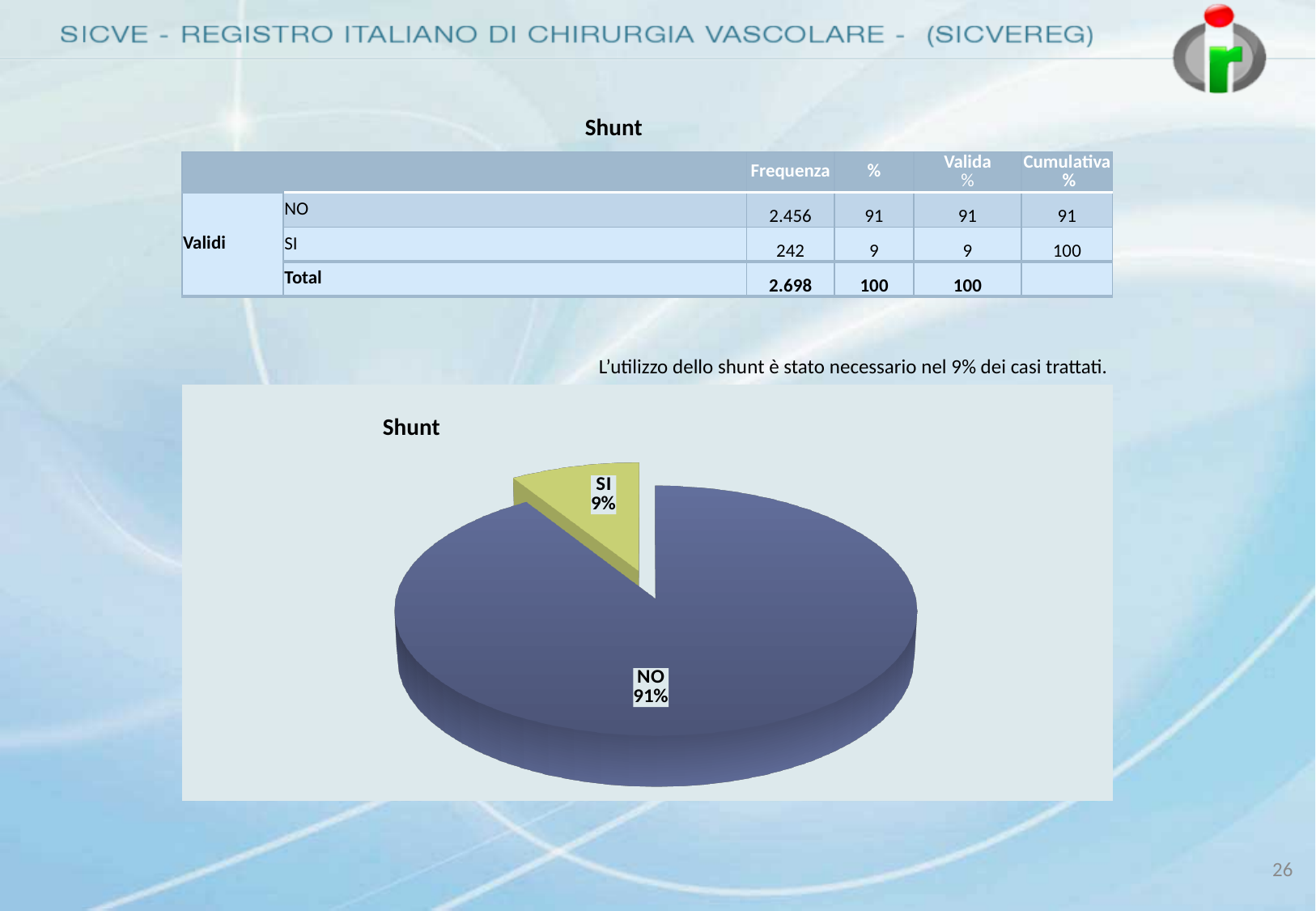
Which slice of the pie is the smallest? SI What colour is the SI slice of the pie? yellow-green What kind of chart is shown on the slide? pie chart What share of the pie does the SI slice represent? 9% What is the title of the chart? Shunt What is the difference in percentage points between the NO slice and the SI slice? 82 How many slices does the pie chart have? 2 What share of the pie does the NO slice represent? 91% Which slice of the pie is the largest? NO Which is larger, the NO slice or the SI slice? NO